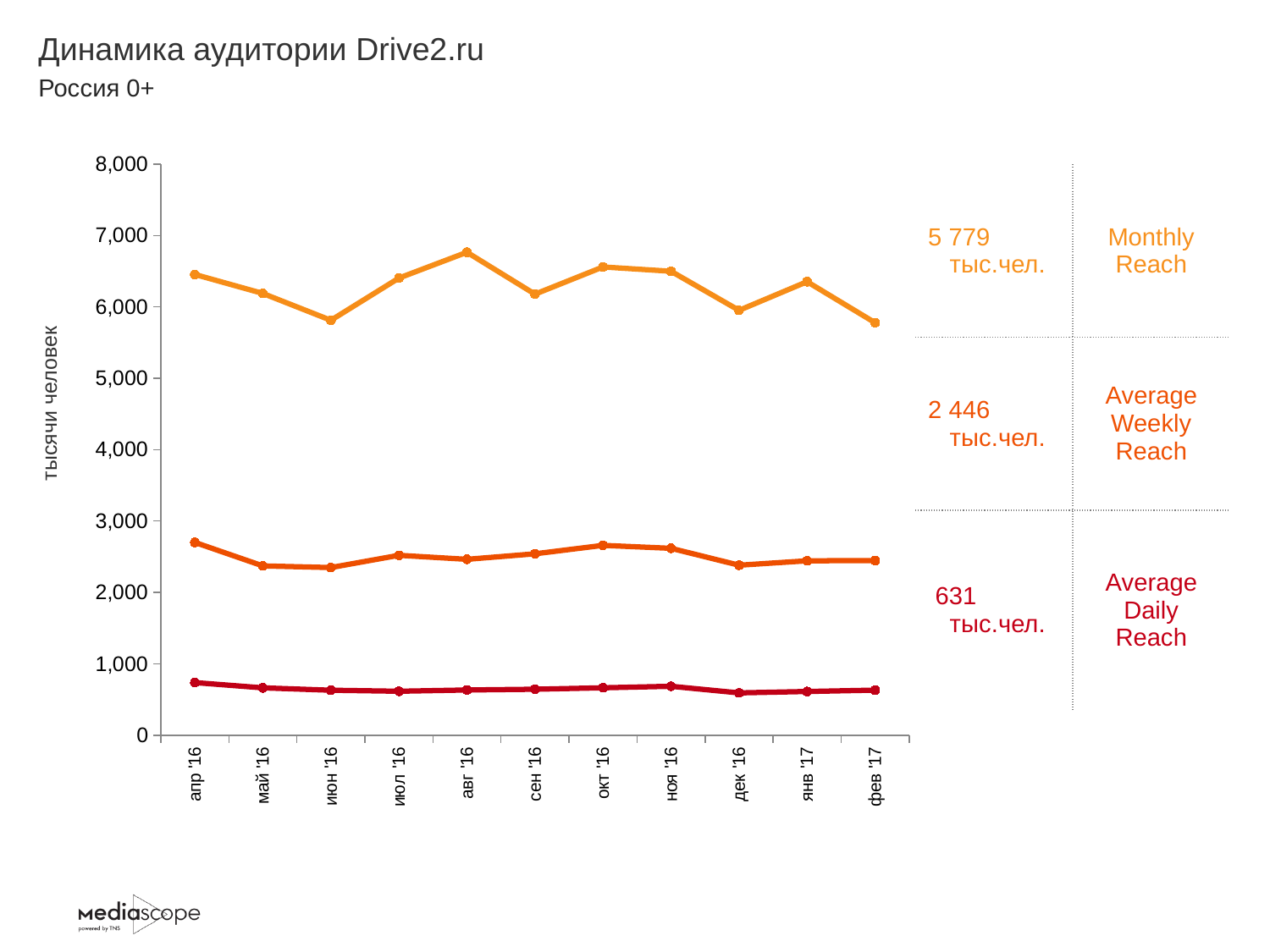
Is the Monthly Reach value for авг '16 greater or less than 6,000? greater What kind of chart is shown on the slide? line chart What Monthly Reach value is printed to the right of the chart? 5 779 тыс.чел. Does the Average Daily Reach line rise or fall from апр '16 to фев '17? fall Which is larger for Monthly Reach: the value for авг '16 or the value for июн '16? авг '16 Is the Average Daily Reach value for апр '16 greater or less than 1,000? less What is the label on the vertical axis of the chart? тысячи человек Is the Average Weekly Reach value for апр '16 greater or less than 2,000? greater In which month does the Monthly Reach line reach its highest point? авг '16 How many months are plotted along the x axis? 11 How many lines (series) are plotted on the chart? 3 What Average Daily Reach value is printed to the right of the chart? 631 тыс.чел.